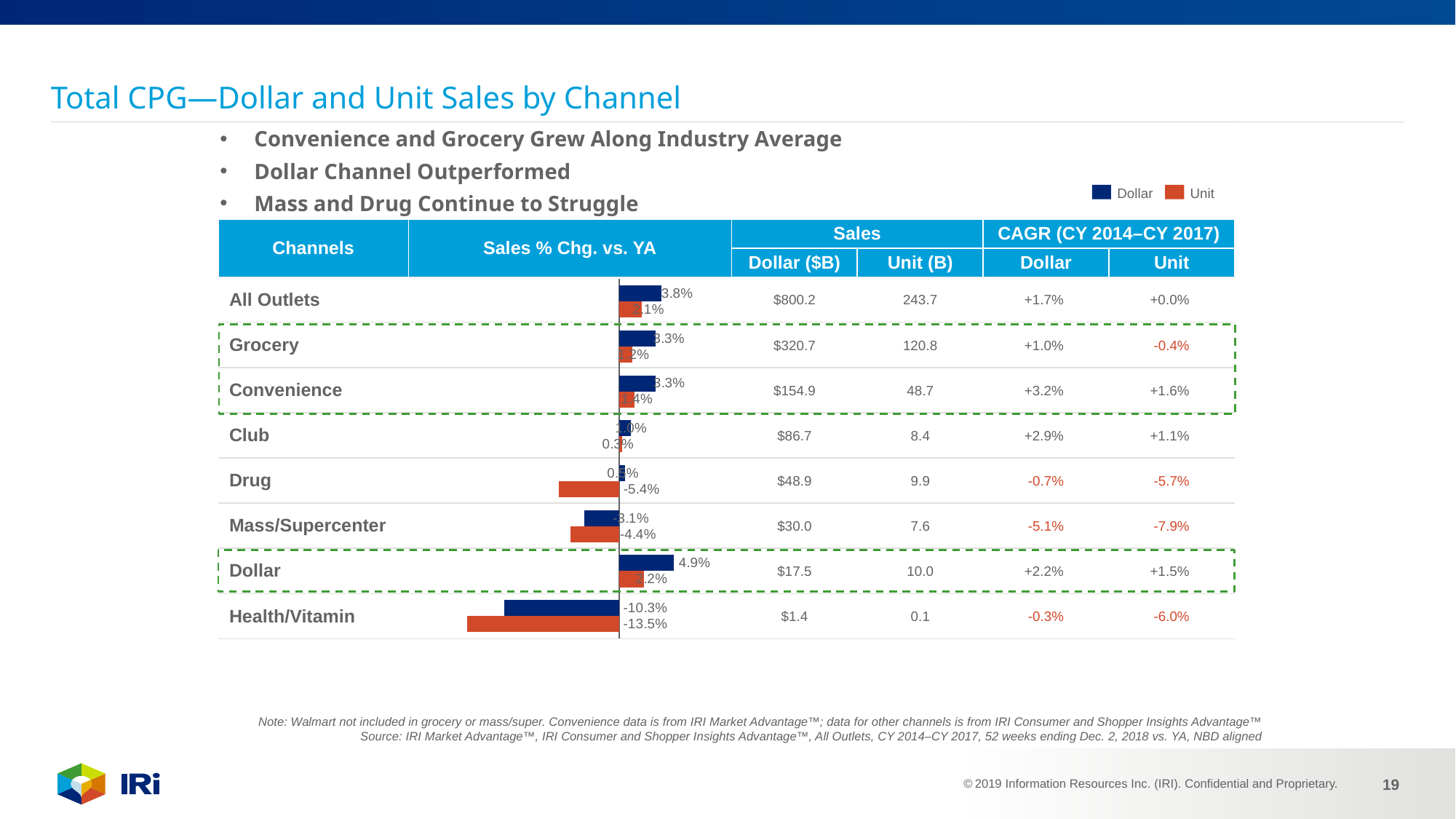
How many channels are plotted in the Sales % Chg. vs. YA chart? 8 In the Sales % Chg. vs. YA chart, what is the Dollar sales % change for the Dollar channel? 4.9% What kind of chart is used for Sales % Chg. vs. YA? Bar chart In the Sales % Chg. vs. YA chart, what is the difference between the Dollar (-10.3%) and Unit (-13.5%) sales % change for Health/Vitamin? 3.2 percentage points In the Sales % Chg. vs. YA chart, which is larger: the Unit sales % change for Drug or for Mass/Supercenter? Mass/Supercenter In the Sales % Chg. vs. YA chart, which is larger: the Dollar sales % change for All Outlets or for the Dollar channel? Dollar In the Sales % Chg. vs. YA chart, what is the Unit sales % change for Drug? -5.4% How many series does the legend of the Sales % Chg. vs. YA chart list? 2 In the Sales % Chg. vs. YA chart, what is the Dollar sales % change for Mass/Supercenter? -3.1% In the Sales % Chg. vs. YA chart, what is the Unit sales % change for Health/Vitamin? -13.5% In the Sales % Chg. vs. YA chart, which channel has the lowest Unit sales % change? Health/Vitamin In the Sales % Chg. vs. YA chart, which channel has the highest Dollar sales % change? Dollar